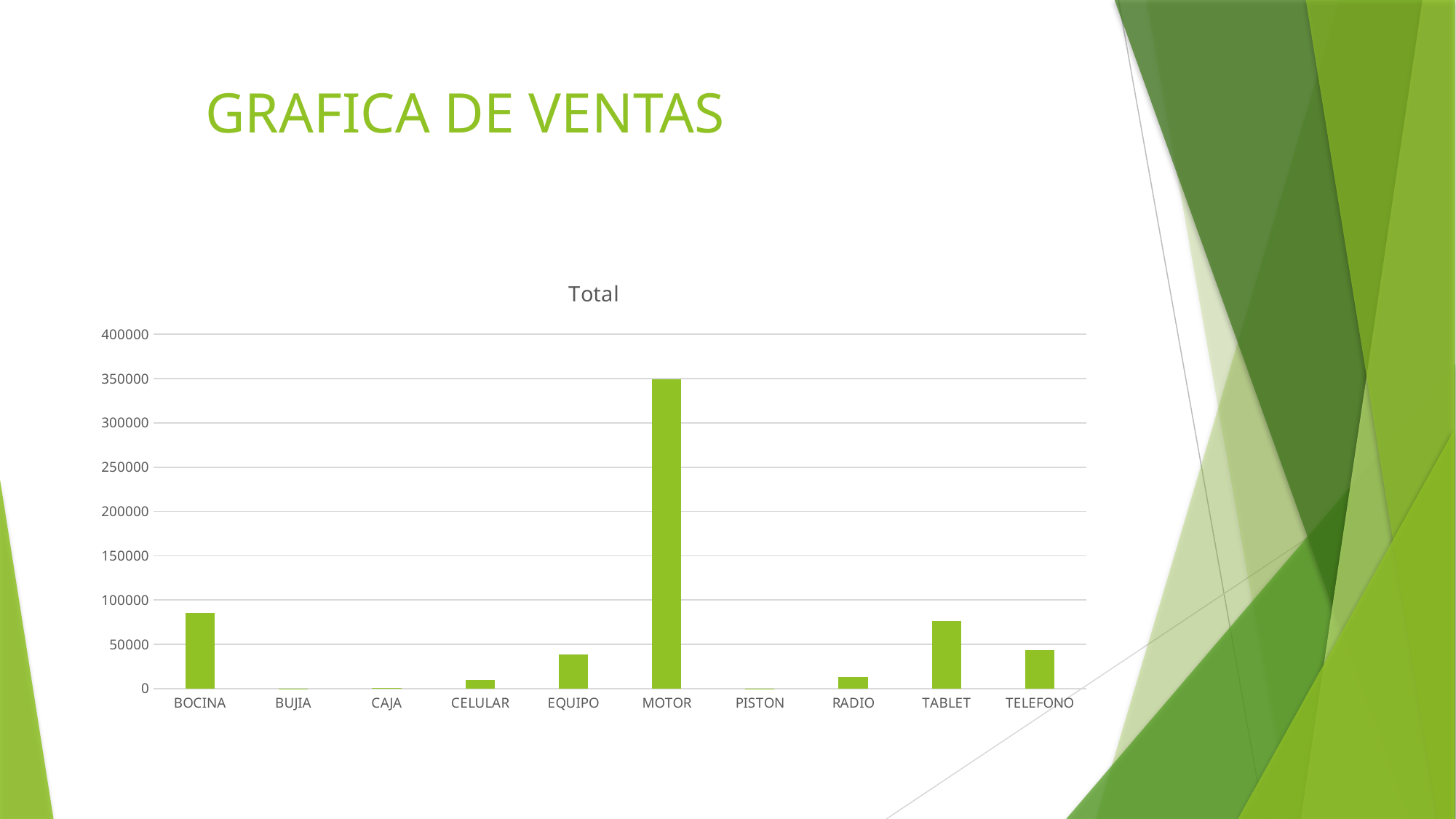
Is the value for EQUIPO greater or less than 50000? less Is the value for RADIO greater or less than 50000? less Is the value for BOCINA greater or less than 100000? less Which is larger, the value for MOTOR or the value for TABLET? MOTOR What is the title of the chart? Total How many categories are shown on the x axis of the chart? 10 What kind of chart is shown on the slide? bar chart Which category has the highest value in the chart? MOTOR Which is larger, the value for BOCINA or the value for TELEFONO? BOCINA